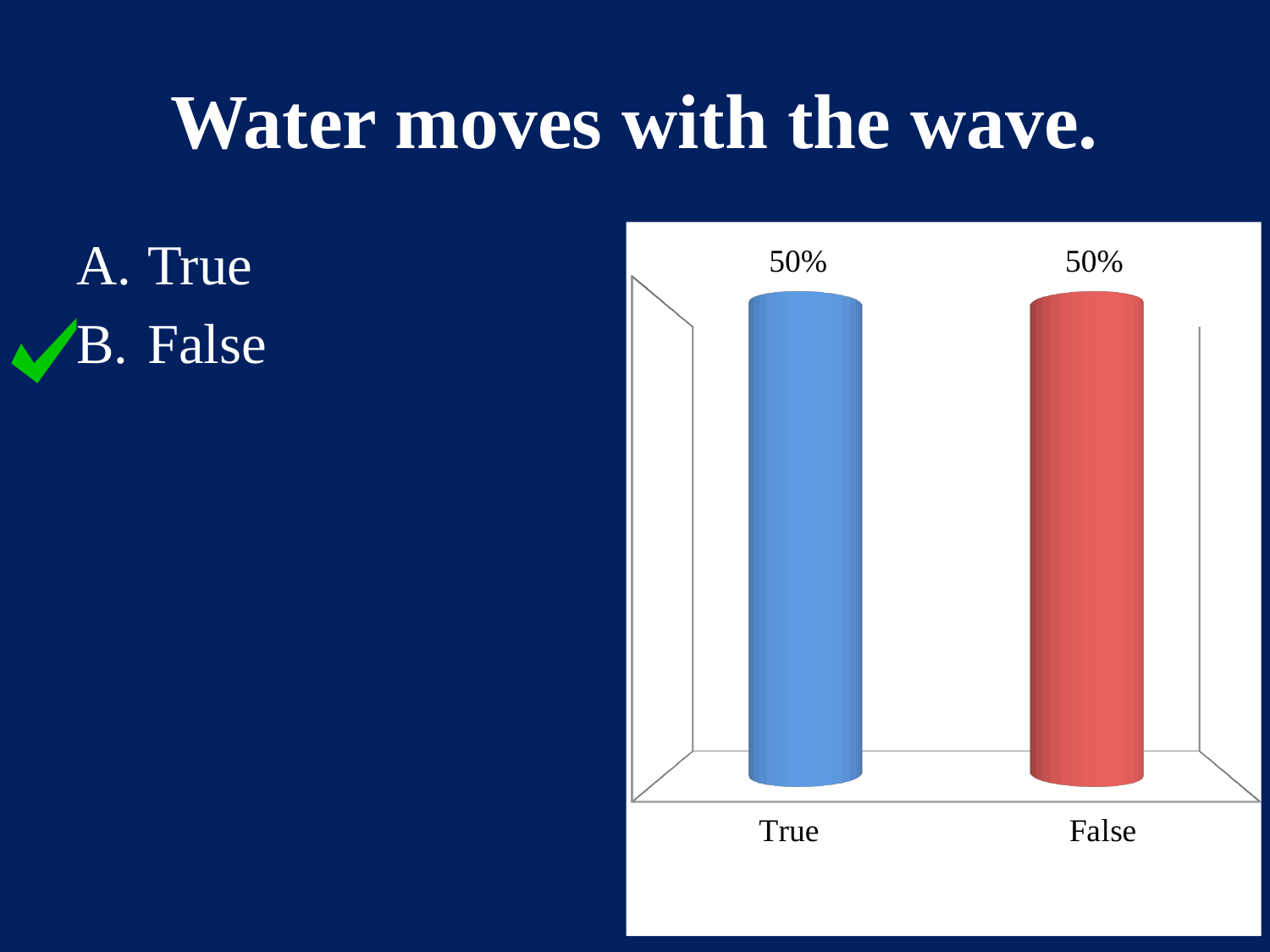
What is the total of the values for True and False? 100% Do the values for True and False differ, or are they equal? equal What is the value shown for False? 50% What is the value shown for True? 50% What are the category labels on the x axis of the chart? True, False What kind of chart is shown on the slide? bar chart What is the difference between the values for True and False? 0% What colour is the bar for False? red How many categories are shown on the chart? 2